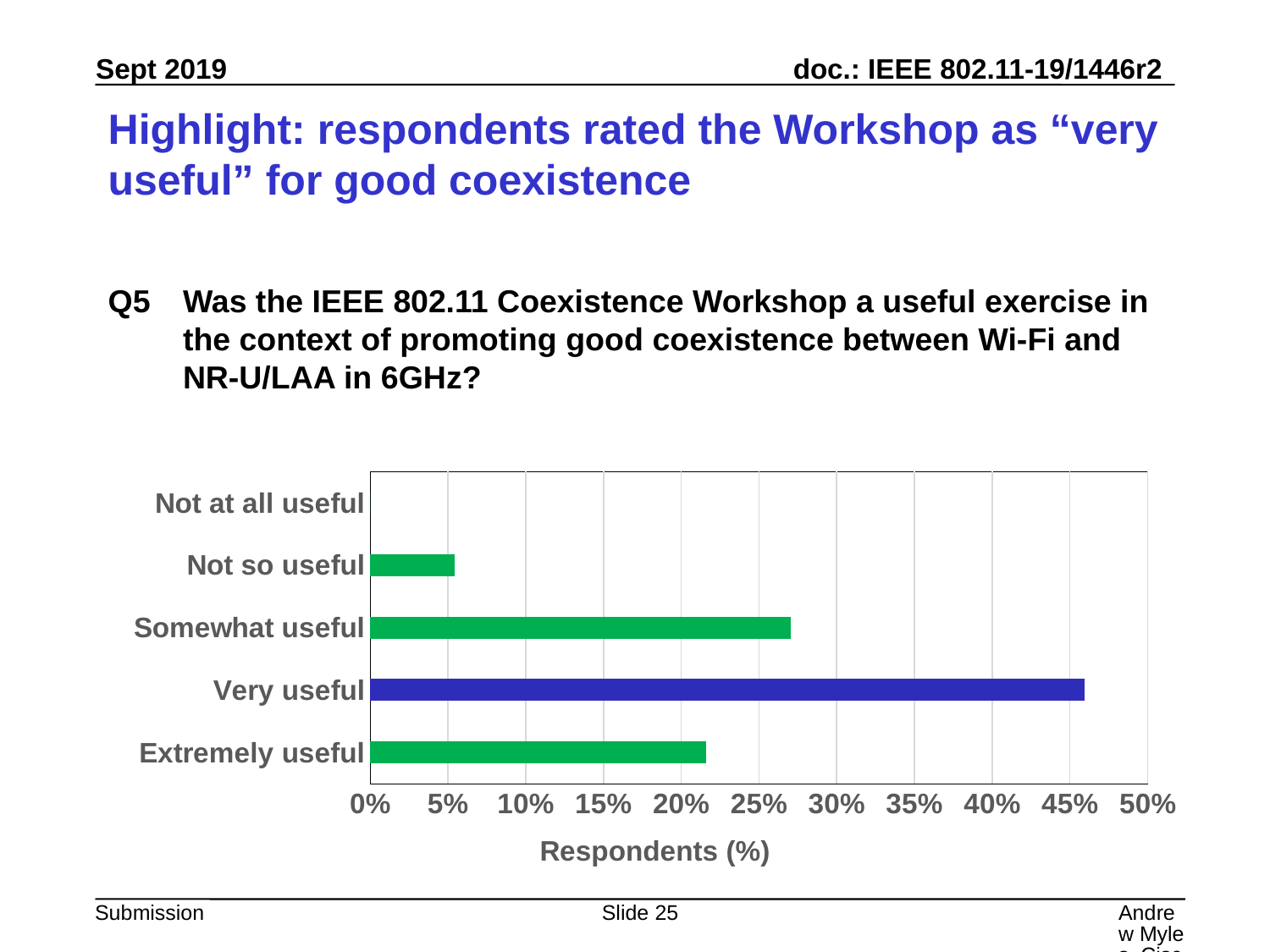
Is the value for Extremely useful greater or less than 25%? less What is the title of the x axis of the chart? Respondents (%) Is the value for Somewhat useful greater or less than 25%? greater Which has a larger share of respondents, Somewhat useful or Extremely useful? Somewhat useful What colour is the bar for Very useful? Blue How many response categories are shown on the y axis of the chart? 5 What kind of chart is shown on the slide? Bar chart Which response category has the highest share of respondents? Very useful Is the value for Very useful greater or less than 40%? greater Which has a larger share of respondents, Not so useful or Extremely useful? Extremely useful Which response category has the lowest share of respondents? Not at all useful